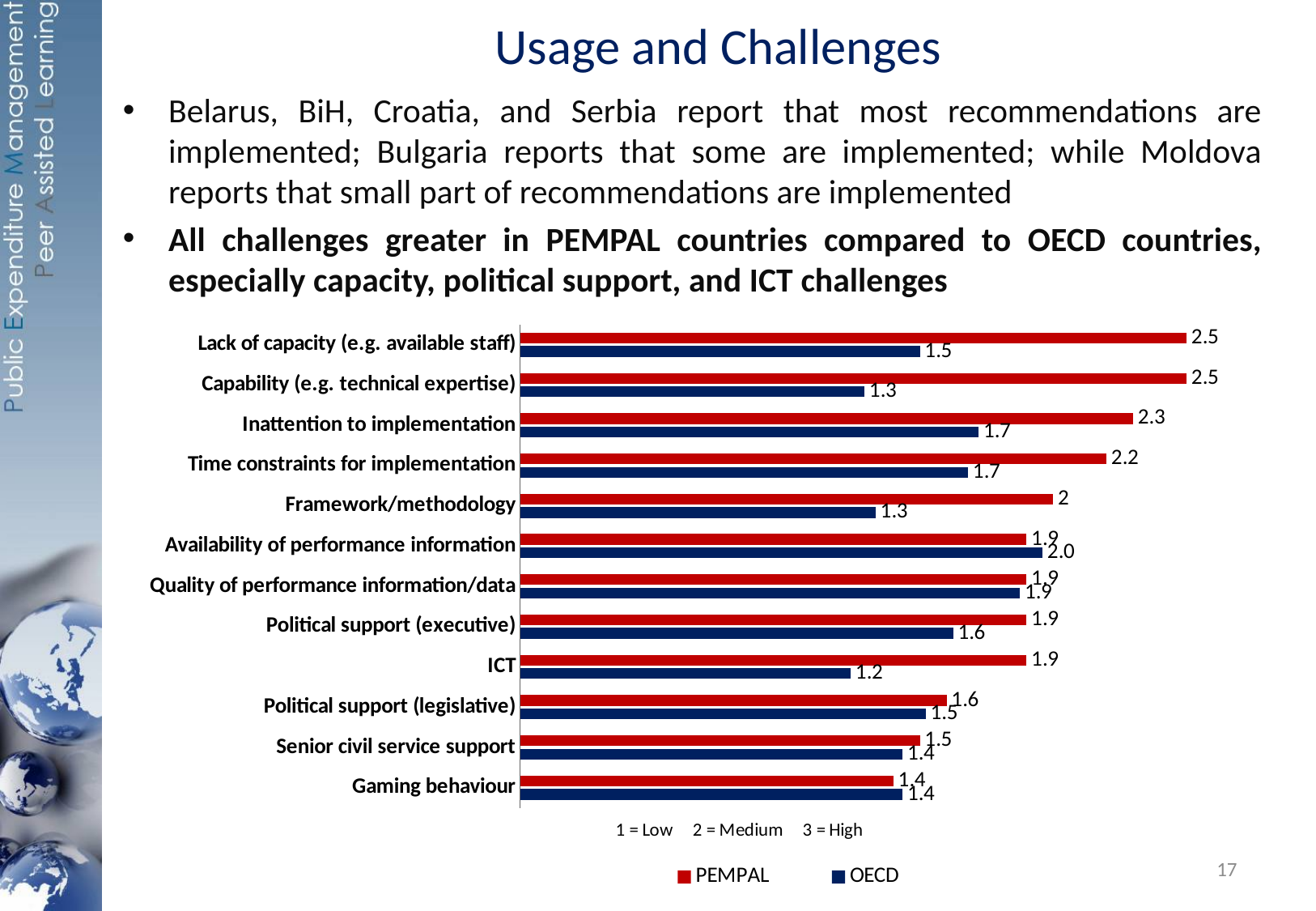
What is the PEMPAL value for Time constraints for implementation? 2.2 What is the difference between the PEMPAL and OECD values for ICT? 0.7 What is the OECD value for Availability of performance information? 2.0 What is the OECD value for ICT? 1.2 What is the PEMPAL value for Lack of capacity (e.g. available staff)? 2.5 How many categories are shown in the chart? 12 What kind of chart is shown on the slide? Bar chart For Capability (e.g. technical expertise), which is larger, the PEMPAL value or the OECD value? PEMPAL What is the OECD value for Framework/methodology? 1.3 What is the difference between the PEMPAL and OECD values for Lack of capacity (e.g. available staff)? 1.0 How many series does the legend list? 2 Which category has the lowest PEMPAL value? Gaming behaviour